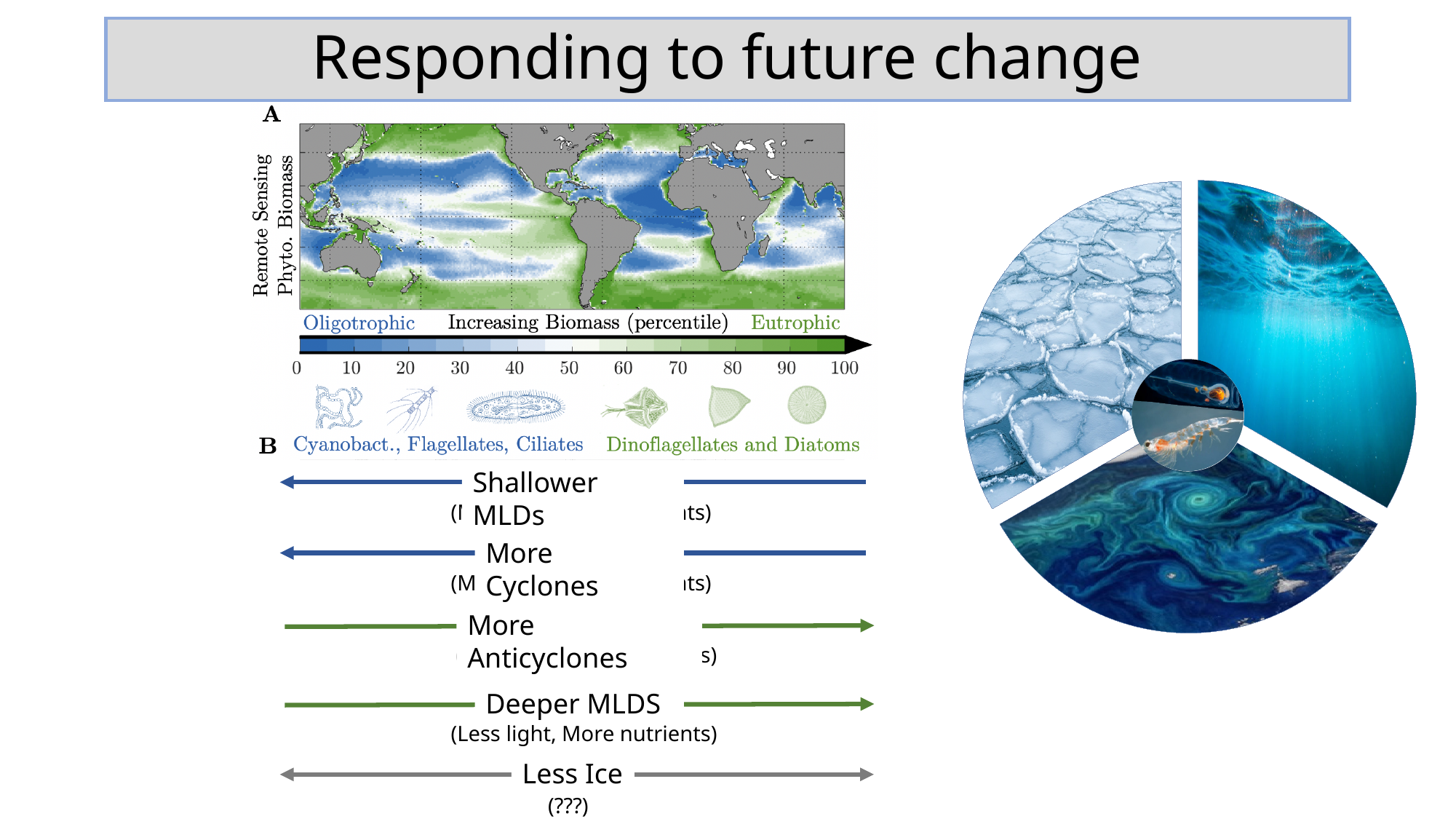
In panel A, how many numbered tick values are printed along the colour scale? 11 In panel A, which label appears at the low (blue) end of the colour scale? Oligotrophic In panel A, what is the colour scale labelled as measuring? Increasing Biomass (percentile) In panel A, what is the vertical axis label on the left of the map? Remote Sensing Phyto. Biomass In panel A, which label appears at the high (green) end of the colour scale? Eutrophic In panel B, what is written in parentheses under 'Less Ice'? (???) In panel A, what is the highest tick value shown on the colour scale below the map? 100 In panel B, how many labelled arrow rows are shown? 5 In panel A, which group of organisms is listed under the oligotrophic (blue) end of the scale? Cyanobact., Flagellates, Ciliates In panel A, which group of organisms is listed under the eutrophic (green) end of the scale? Dinoflagellates and Diatoms In panel B, what is written in parentheses under 'Deeper MLDS'? (Less light, More nutrients) In panel A, what is the lowest tick value shown on the colour scale below the map? 0